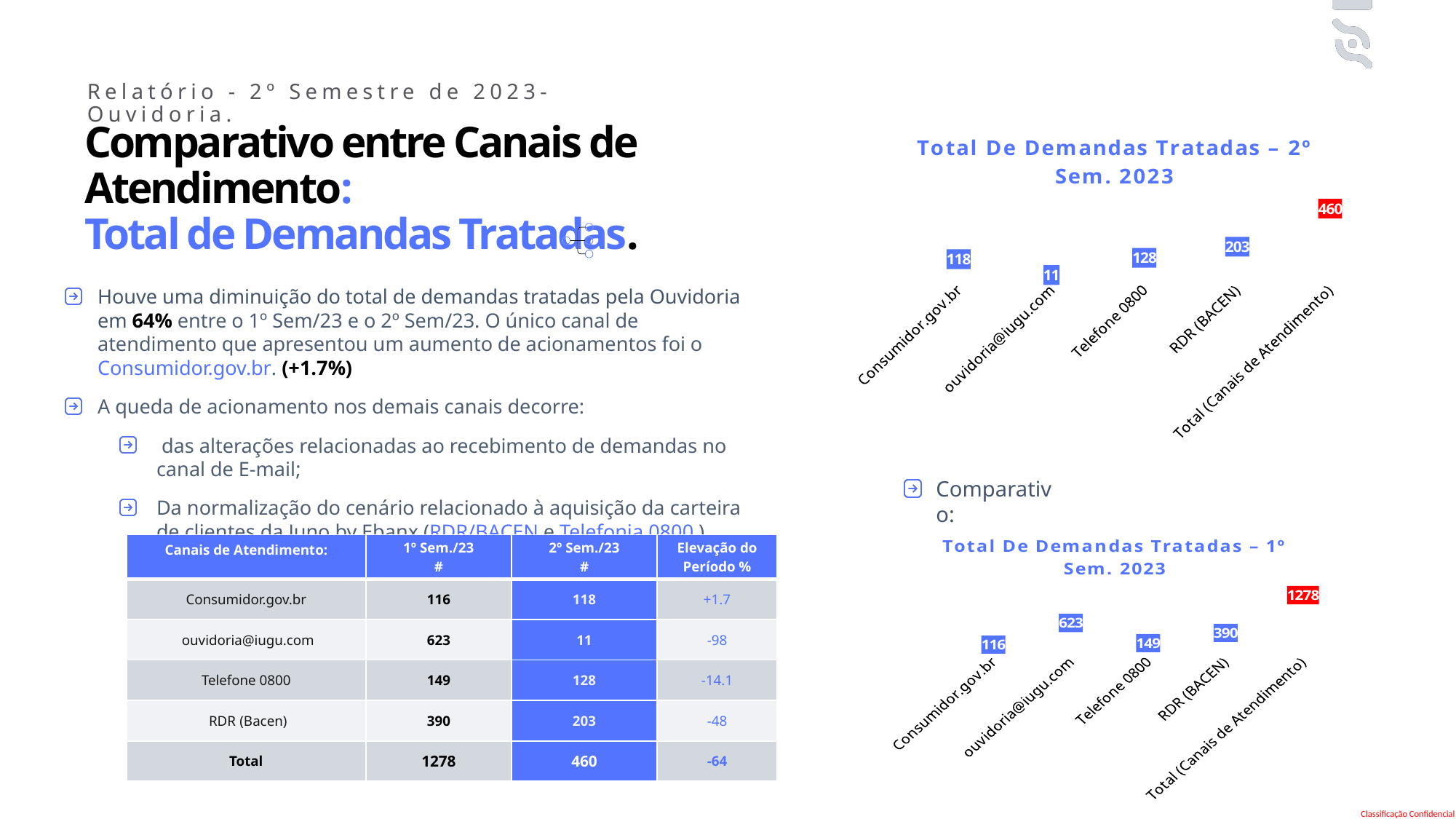
How many categories are shown in the chart titled "Total De Demandas Tratadas – 1º Sem. 2023"? 5 In the chart titled "Total De Demandas Tratadas – 2º Sem. 2023", what is the value for Total (Canais de Atendimento)? 460 In the chart titled "Total De Demandas Tratadas – 1º Sem. 2023", which individual channel (excluding the total) has the highest value? ouvidoria@iugu.com In the chart titled "Total De Demandas Tratadas – 2º Sem. 2023", which category has the lowest value? ouvidoria@iugu.com In the chart titled "Total De Demandas Tratadas – 2º Sem. 2023", what is the value for ouvidoria@iugu.com? 11 In the chart titled "Total De Demandas Tratadas – 1º Sem. 2023", is the value for Telefone 0800 larger or smaller than the value for Consumidor.gov.br? larger In the chart titled "Total De Demandas Tratadas – 1º Sem. 2023", which category has the lowest value? Consumidor.gov.br In the chart titled "Total De Demandas Tratadas – 2º Sem. 2023", which individual channel (excluding the total) has the highest value? RDR (BACEN) In the chart titled "Total De Demandas Tratadas – 1º Sem. 2023", what is the value for ouvidoria@iugu.com? 623 In the chart titled "Total De Demandas Tratadas – 1º Sem. 2023", what is the value for RDR (BACEN)? 390 In the chart titled "Total De Demandas Tratadas – 2º Sem. 2023", what is the difference between the values for RDR (BACEN) and Telefone 0800? 75 In the chart titled "Total De Demandas Tratadas – 2º Sem. 2023", what is the value for Consumidor.gov.br? 118